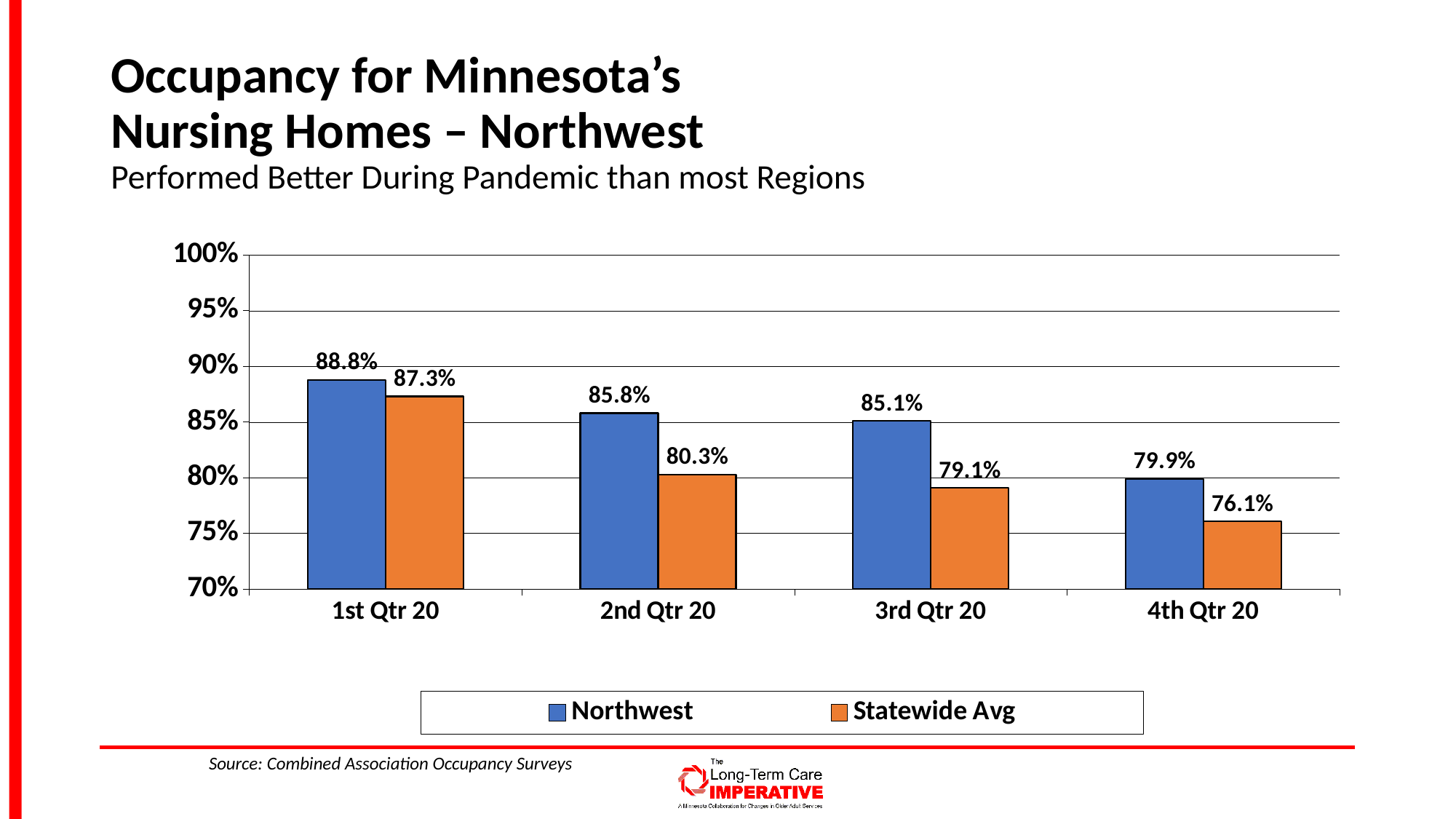
Do the Northwest values rise or fall from 1st Qtr 20 to 4th Qtr 20? Fall How many series does the legend list? 2 What kind of chart is shown on the slide? Bar chart In which quarter is the Northwest occupancy highest? 1st Qtr 20 How many quarters are shown on the x axis? 4 Which is larger in 2nd Qtr 20, the Northwest value or the Statewide Avg value? Northwest What is the Statewide Avg occupancy value for 4th Qtr 20? 76.1% In which quarter is the Statewide Avg occupancy lowest? 4th Qtr 20 What is the Northwest occupancy value for 1st Qtr 20? 88.8% What is the Statewide Avg occupancy value for 2nd Qtr 20? 80.3% What is the difference between the Northwest and Statewide Avg values in 3rd Qtr 20? 6.0% Is the Northwest value for 4th Qtr 20 greater or less than 85%? less